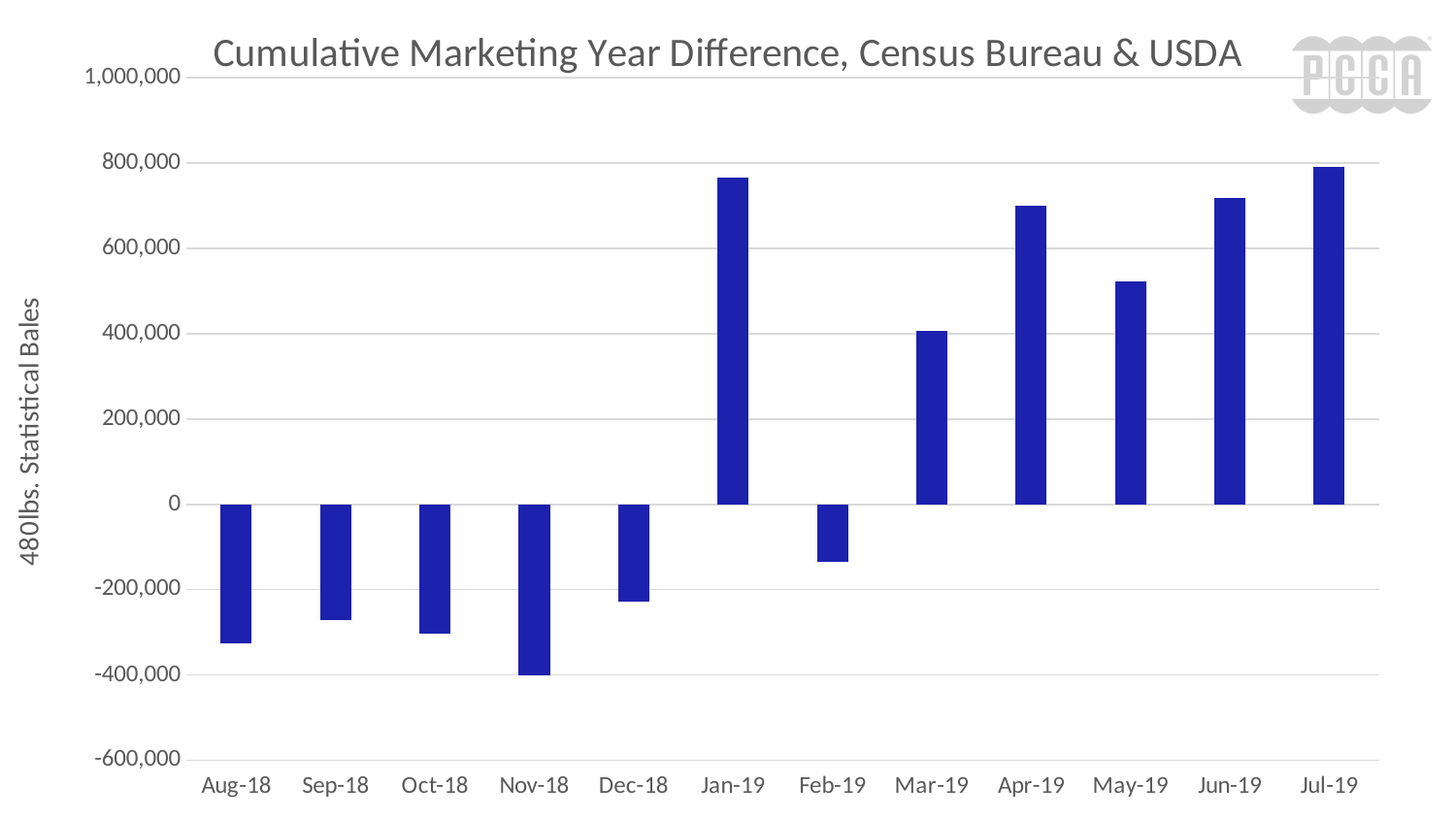
Is the value for Aug-18 greater or less than -200,000? less Which month has the highest value? Jul-19 Is the value for Jan-19 greater or less than 600,000? greater Is the value for May-19 greater or less than 600,000? less Which month has the lowest (most negative) value? Nov-18 What is the label on the vertical axis? 480lbs. Statistical Bales What kind of chart is shown on the slide? bar chart What is the title of the chart? Cumulative Marketing Year Difference, Census Bureau & USDA Which is larger, the value for Sep-18 or the value for Nov-18? Sep-18 How many months are plotted on the x axis? 12 Which is larger, the value for Jun-19 or the value for May-19? Jun-19